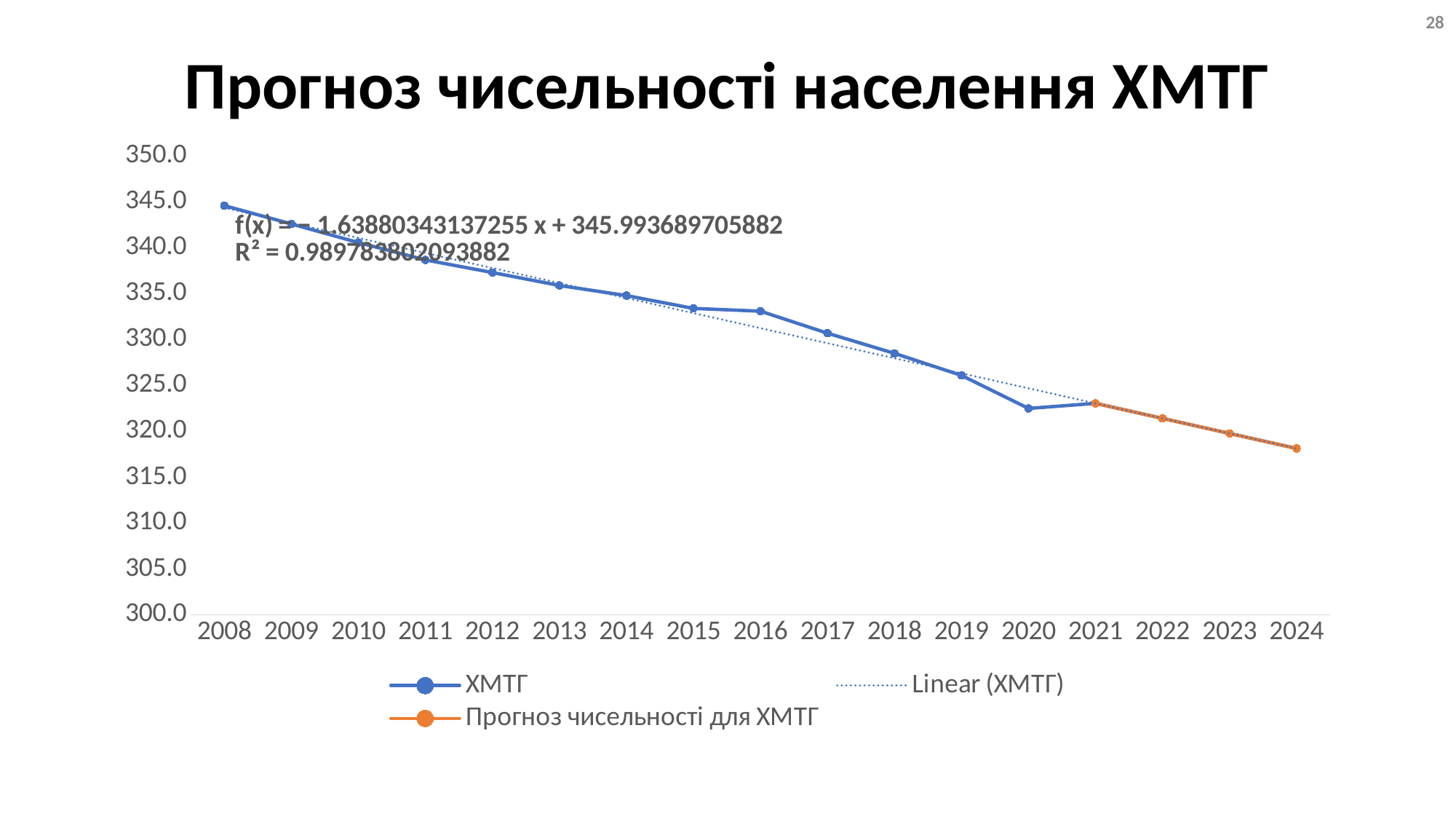
What kind of chart is shown on the slide? line chart Which is larger, the value for 2012 or the value for 2018? 2012 Which year has the highest value on the chart? 2008 What is the title of the chart? Прогноз чисельності населення ХМТГ What R² value is printed on the chart for the linear trendline? 0.989783802093882 How many years are shown on the x axis of the chart? 17 How many entries does the chart legend list? 3 Which year has the lowest value on the chart? 2024 Is the value for 2008 greater or less than 340.0? greater Is the value for 2020 greater or less than 325.0? less Is the value for 2024 greater or less than 320.0? less Do the values rise or fall from 2008 to 2024 along the x axis? fall